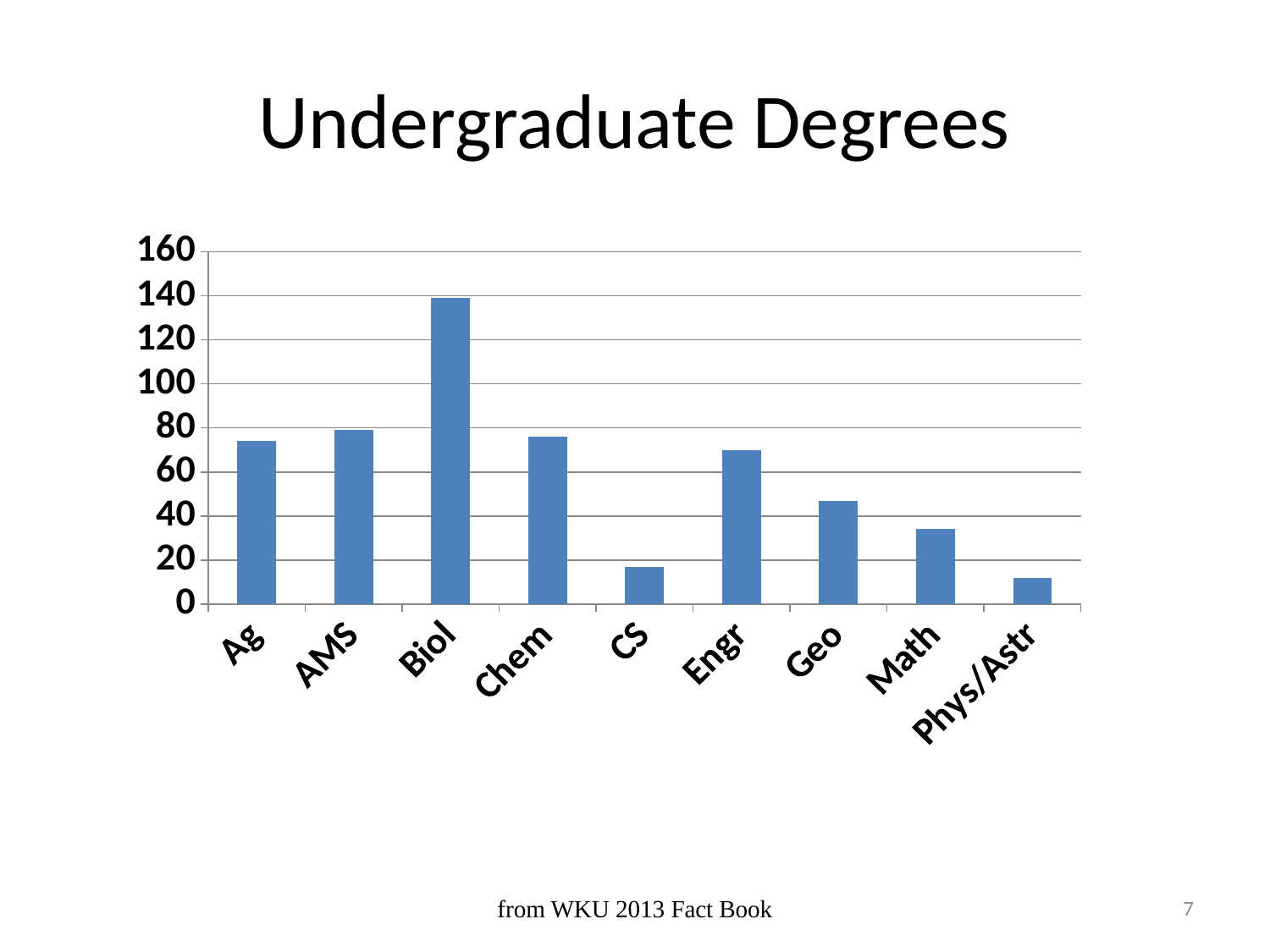
Which is larger, the value for Geo or the value for Math? Geo Is the value for Geo greater or less than 40? greater Is the value for Engr greater or less than 60? greater What is the title of the chart? Undergraduate Degrees How many categories are shown on the x axis? 9 Is the value for Biol greater or less than 120? greater Which category has the lowest number of undergraduate degrees? Phys/Astr Which category has the highest number of undergraduate degrees? Biol Which is larger, the value for CS or the value for Engr? Engr What kind of chart is shown on the slide? bar chart